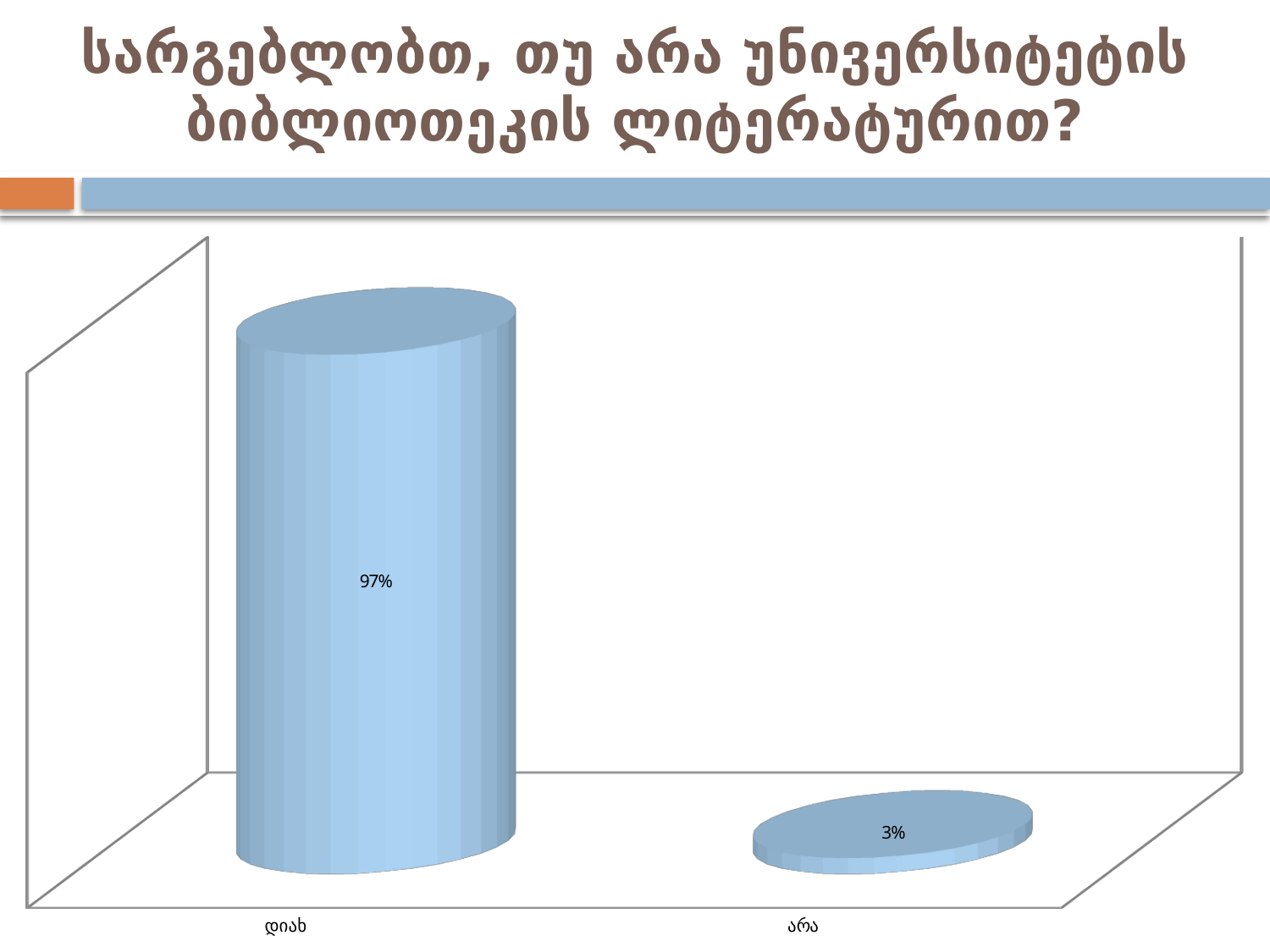
What is the difference between the values for დიახ and არა? 94% Which category has the lowest value? არა How many categories are shown on the chart? 2 Do the values rise or fall from left to right along the x axis? fall What kind of chart is shown on the slide? bar chart Which category has the highest value? დიახ What is the total of the two values shown on the chart? 100% What colour are the bars on the chart? light blue What is the title of the slide? სარგებლობთ, თუ არა უნივერსიტეტის ბიბლიოთეკის ლიტერატურით? Which is larger, the value for დიახ or the value for არა? დიახ What is the value for არა? 3% What is the value for დიახ? 97%